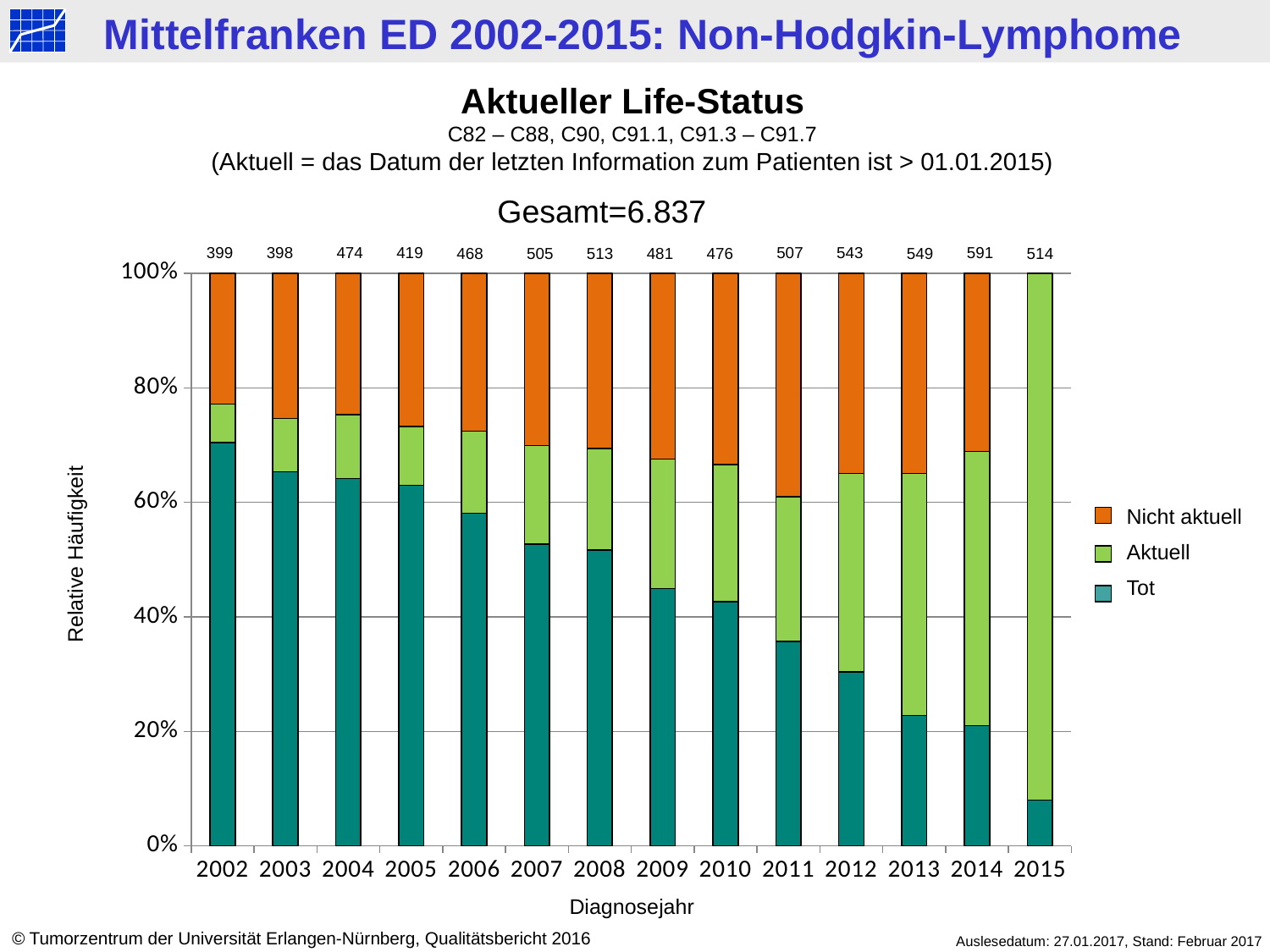
Is the share of 'Tot' in 2002 greater or less than 60%? greater Which diagnosis year has the highest number printed above its bar? 2014 How many diagnosis years are shown on the x axis? 14 What is the difference between the numbers printed above the bars for 2014 and 2015? 77 How many series does the legend list? 3 Which diagnosis year has the lowest number printed above its bar? 2003 Which has the larger number printed above its bar, 2011 or 2012? 2012 What is the number printed above the bar for 2002? 399 Does the share of 'Tot' rise or fall from 2002 to 2015? fall What is the number printed above the bar for 2014? 591 What kind of chart is shown on the slide? bar chart What is the number printed above the bar for 2009? 481